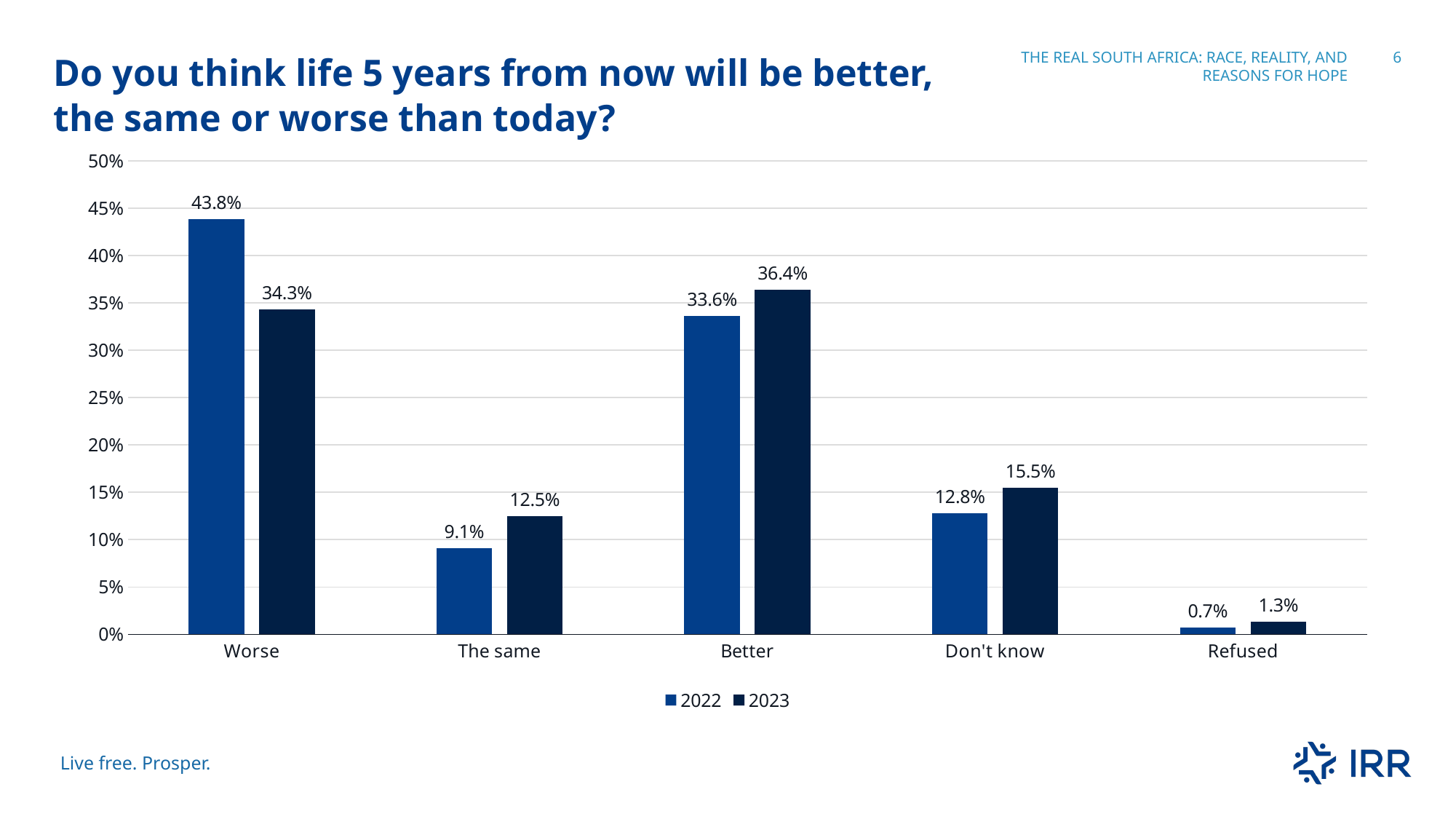
What kind of chart is shown on the slide? Bar chart Is the value for 'Better' in 2022 greater or less than 30%? greater Which is larger: 'The same' in 2023 or 'Don't know' in 2022? Don't know in 2022 How many response categories are shown on the x axis? 5 What is the value for 'Don't know' in 2022? 12.8% What percentage of respondents said 'Worse' in 2022? 43.8% By how many percentage points did the 'Worse' response fall from 2022 to 2023? 9.5 percentage points What percentage of respondents said 'Better' in 2023? 36.4% How many series does the legend list? 2 Which years are listed in the legend? 2022 and 2023 Which category has the lowest value for 2022? Refused Which category has the highest value for 2023? Better